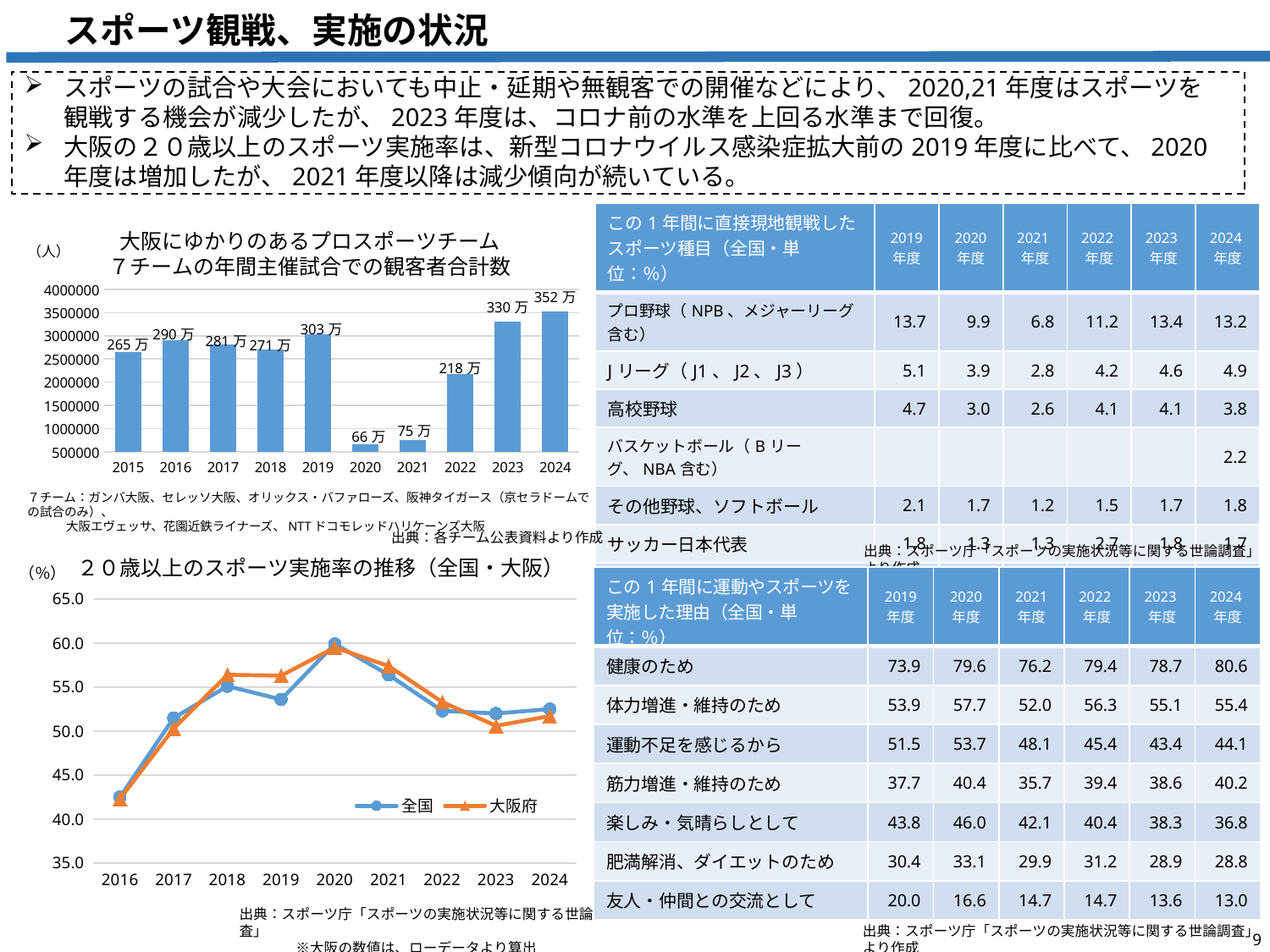
In the bar chart of annual spectator totals for the 7 Osaka-linked pro sports teams, what is the difference between the 2024 and 2023 values? 22万 In the line chart of sports participation rate for people aged 20 and over, do the 全国 values rise or fall from 2020 to 2024? fall How many years are shown in the bar chart of annual spectator totals for the 7 Osaka-linked pro sports teams? 10 In the line chart of sports participation rate for people aged 20 and over, is the 全国 value for 2020 greater or less than 55.0? greater In the bar chart of annual spectator totals for the 7 Osaka-linked pro sports teams, what is the value for 2020? 66万 In the bar chart of annual spectator totals for the 7 Osaka-linked pro sports teams, which year has the lowest value? 2020 In the bar chart of annual spectator totals for the 7 Osaka-linked pro sports teams, which year has the larger value, 2016 or 2017? 2016 What kind of chart is the top-left chart showing spectator totals for the 7 Osaka-linked pro sports teams? Bar chart How many series does the legend list in the line chart of sports participation rate for people aged 20 and over? 2 In the bar chart of annual spectator totals for the 7 Osaka-linked pro sports teams, which year has the highest value? 2024 In the bar chart of annual spectator totals for the 7 Osaka-linked pro sports teams, what is the value for 2024? 352万 In the line chart of sports participation rate for people aged 20 and over, is the 全国 value for 2016 greater or less than 45.0? less